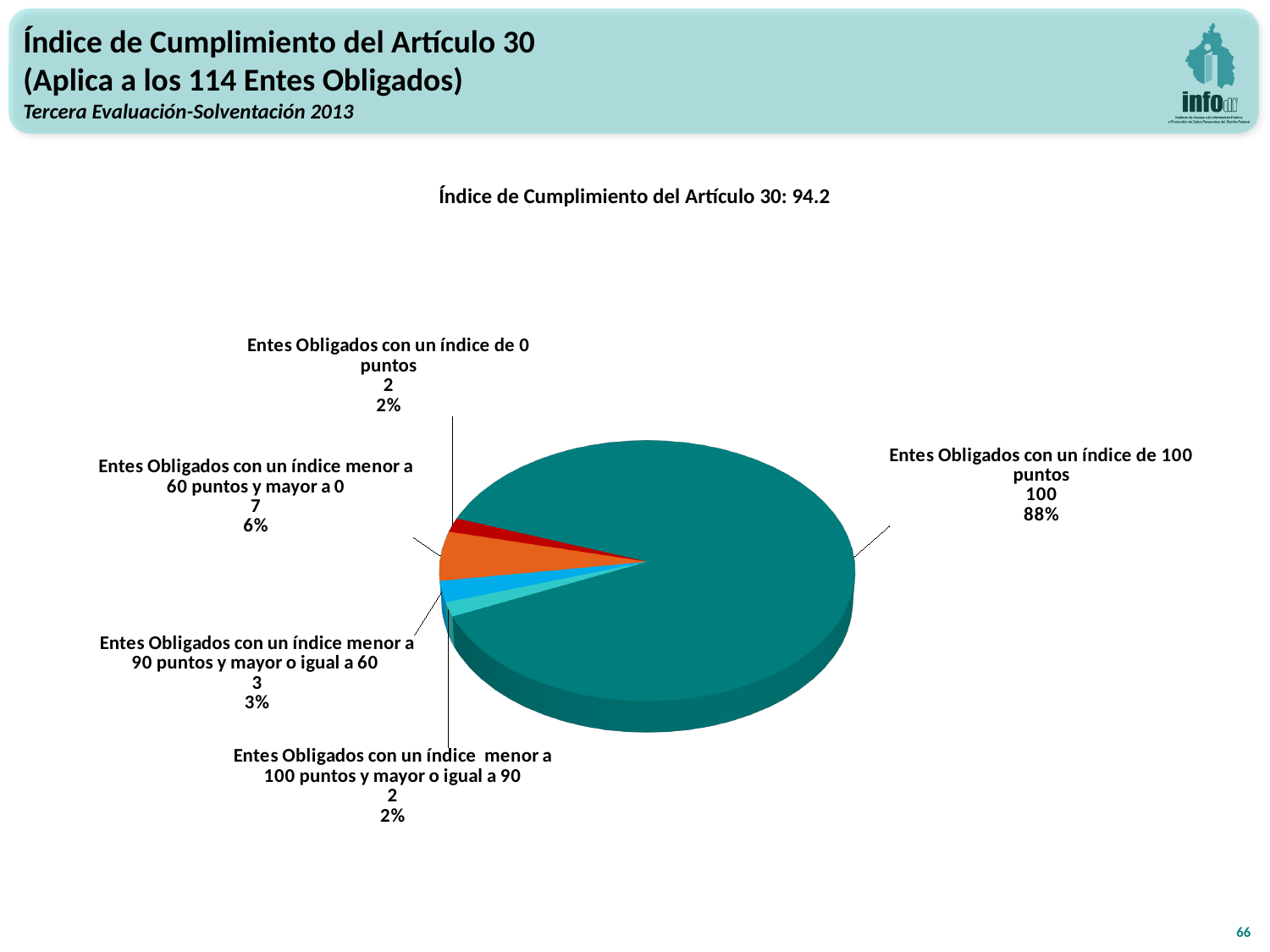
What kind of chart is shown on the slide? Pie chart How many Entes Obligados have an índice menor a 60 puntos y mayor a 0? 7 What is the total number of Entes Obligados across all slices of the pie? 114 Which is larger: the number of Entes Obligados con un índice menor a 60 puntos y mayor a 0, or the number con un índice menor a 90 puntos y mayor o igual a 60? Entes Obligados con un índice menor a 60 puntos y mayor a 0 How many Entes Obligados have an índice de 100 puntos? 100 How many Entes Obligados have an índice de 0 puntos? 2 How many slices does the pie chart have? 5 Which category has the largest slice of the pie? Entes Obligados con un índice de 100 puntos What is the difference between the number of Entes Obligados con un índice de 100 puntos and those con un índice menor a 60 puntos y mayor a 0? 93 What percentage of the pie corresponds to Entes Obligados con un índice menor a 90 puntos y mayor o igual a 60? 3% What share of the pie do the Entes Obligados con un índice de 100 puntos represent? 88% What is the Índice de Cumplimiento del Artículo 30 stated above the chart? 94.2